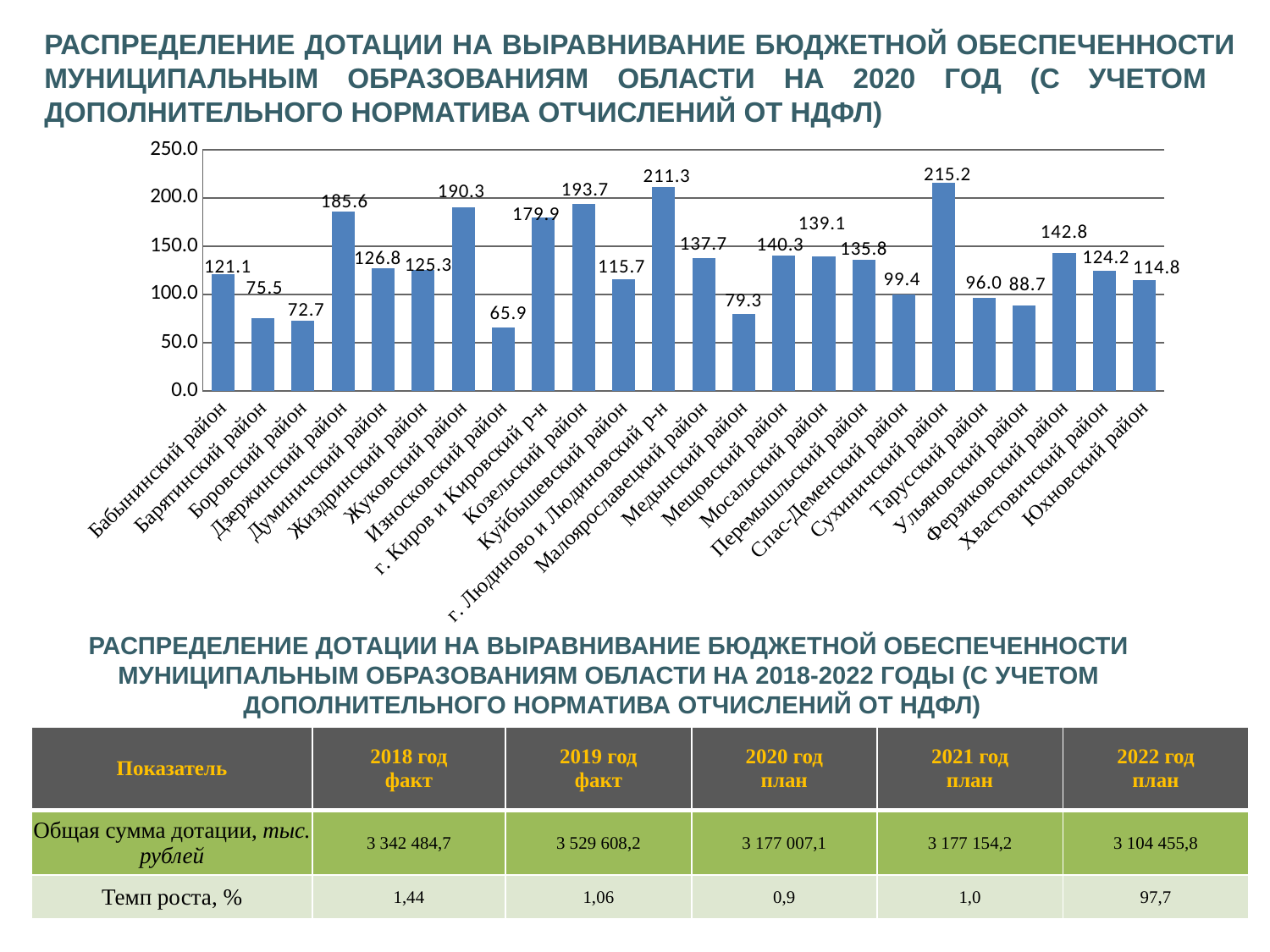
Is the value for Медынский район greater or less than 100.0? less What kind of chart is shown on the slide? bar chart What is the highest tick value on the vertical axis of the chart? 250.0 Which municipality has the lowest value in the chart? Износковский район What is the value for Износковский район? 65.9 What is the value for г. Людиново и Людиновский р-н? 211.3 What is the difference between the values for Сухиничский район and Износковский район? 149.3 Which has a larger value, Жуковский район or Козельский район? Козельский район What is the value for Сухиничский район? 215.2 Which municipality has the highest value in the chart? Сухиничский район How many municipalities are shown in the chart? 24 What is the difference between the values for Дзержинский район and Бабынинский район? 64.5